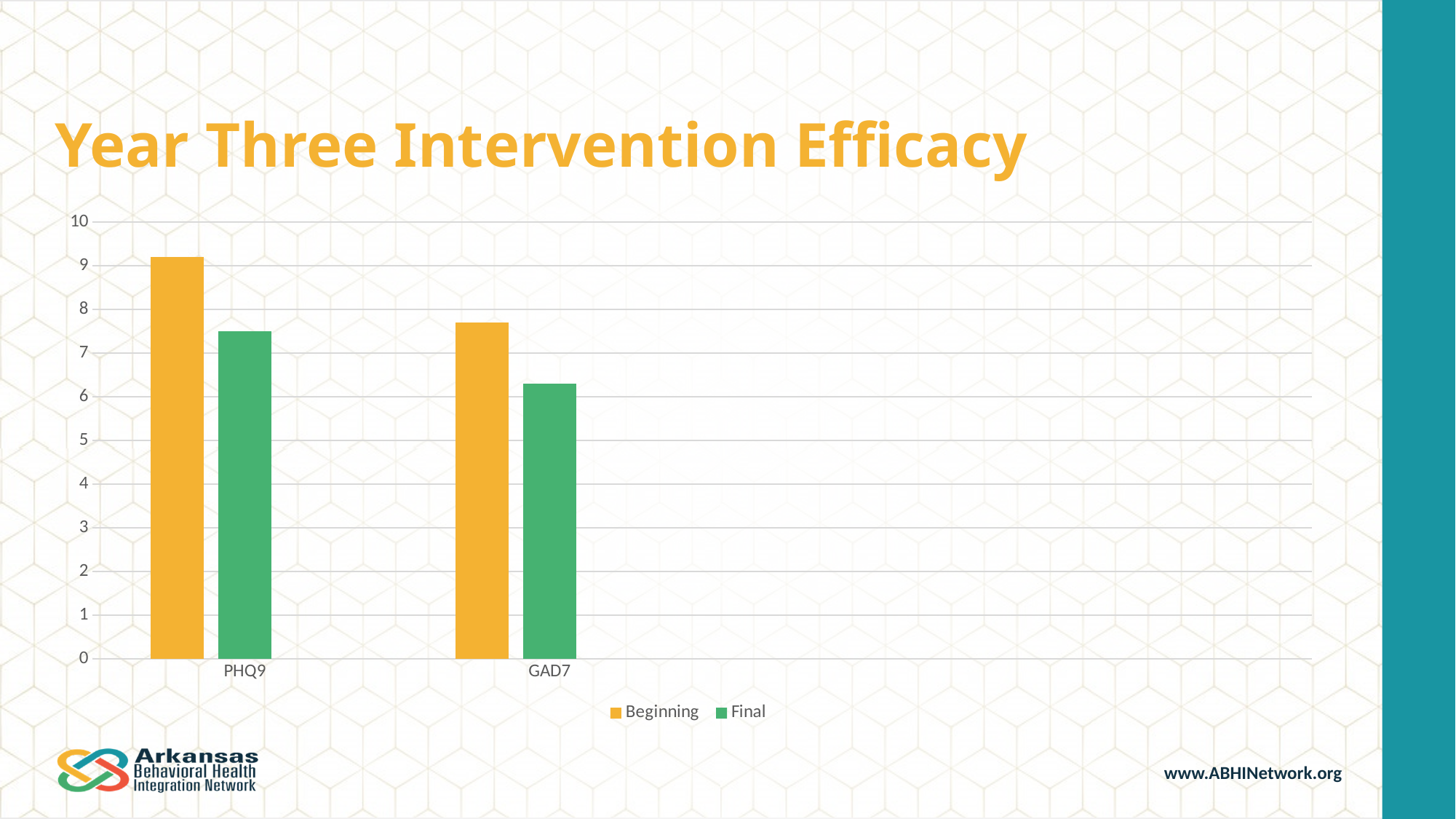
Is the Final value for PHQ9 greater or less than 8? less Which bar is the shortest in the chart? GAD7 Final For GAD7, which is larger: the Beginning value or the Final value? Beginning For PHQ9, which is larger: the Beginning value or the Final value? Beginning How many series does the legend list? 2 Is the Final value for GAD7 greater or less than 7? less Which colour represents the Final series? green How many categories are shown on the x axis? 2 Which bar is the tallest in the chart? PHQ9 Beginning What is the title of the chart on the slide? Year Three Intervention Efficacy What kind of chart is shown on the slide? bar chart Is the Beginning value for PHQ9 greater or less than 8? greater